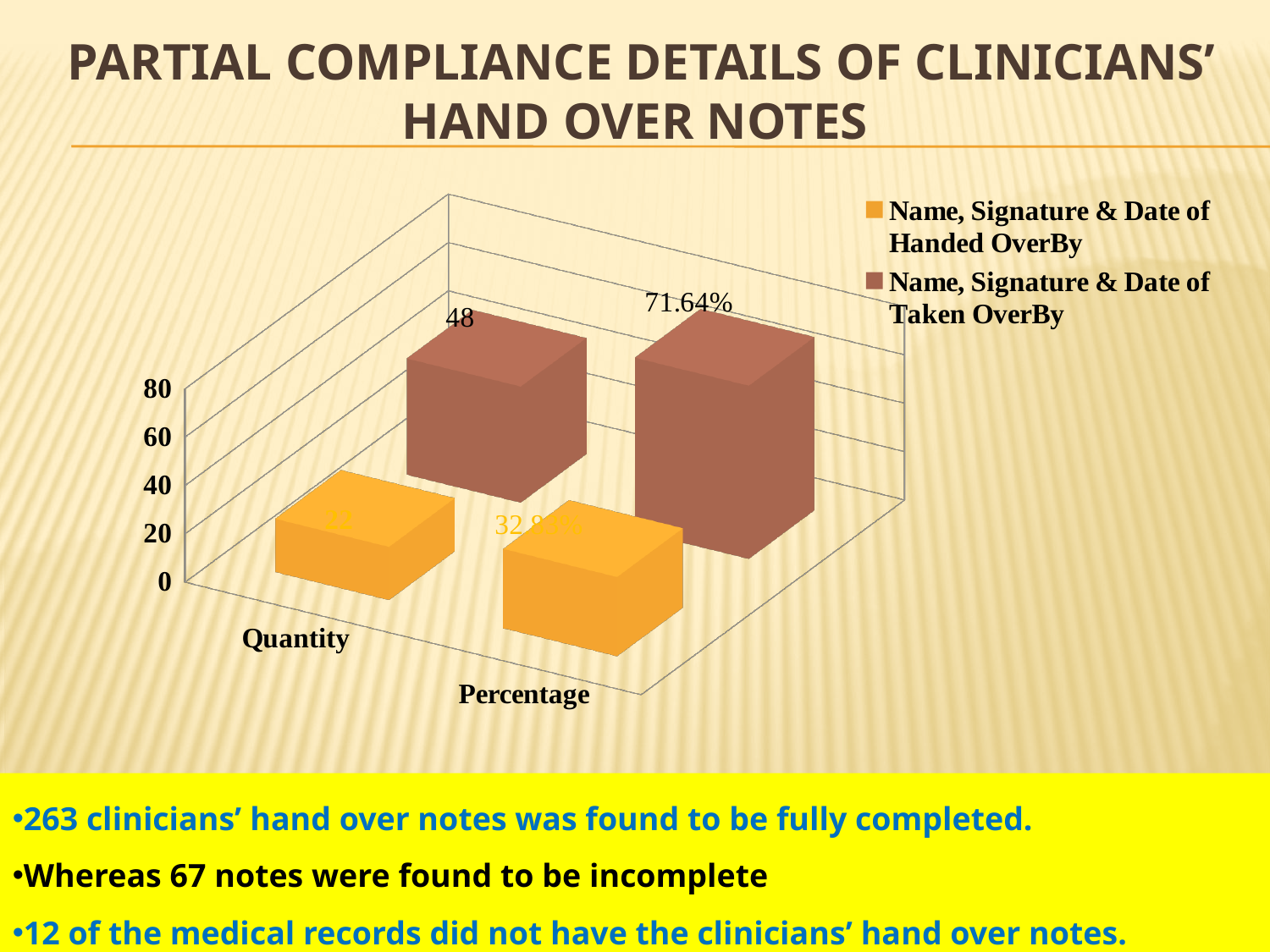
Which series has the higher Quantity value? Name, Signature & Date of Taken OverBy Which series has the higher Percentage value? Name, Signature & Date of Taken OverBy Is the Quantity value for 'Name, Signature & Date of Handed OverBy' greater or less than 40? less What is the highest value shown on the vertical axis of the chart? 80 What are the two categories shown on the x axis of the chart? Quantity and Percentage Is the Percentage value for 'Name, Signature & Date of Handed OverBy' greater or less than 60? less What is the Percentage value for the series 'Name, Signature & Date of Taken OverBy'? 71.64% Is the Quantity value for 'Name, Signature & Date of Taken OverBy' greater or less than 40? greater What kind of chart is shown on the slide? bar chart What is the Quantity value for the series 'Name, Signature & Date of Taken OverBy'? 48 How many categories are shown on the x axis of the chart? 2 How many series does the legend list? 2